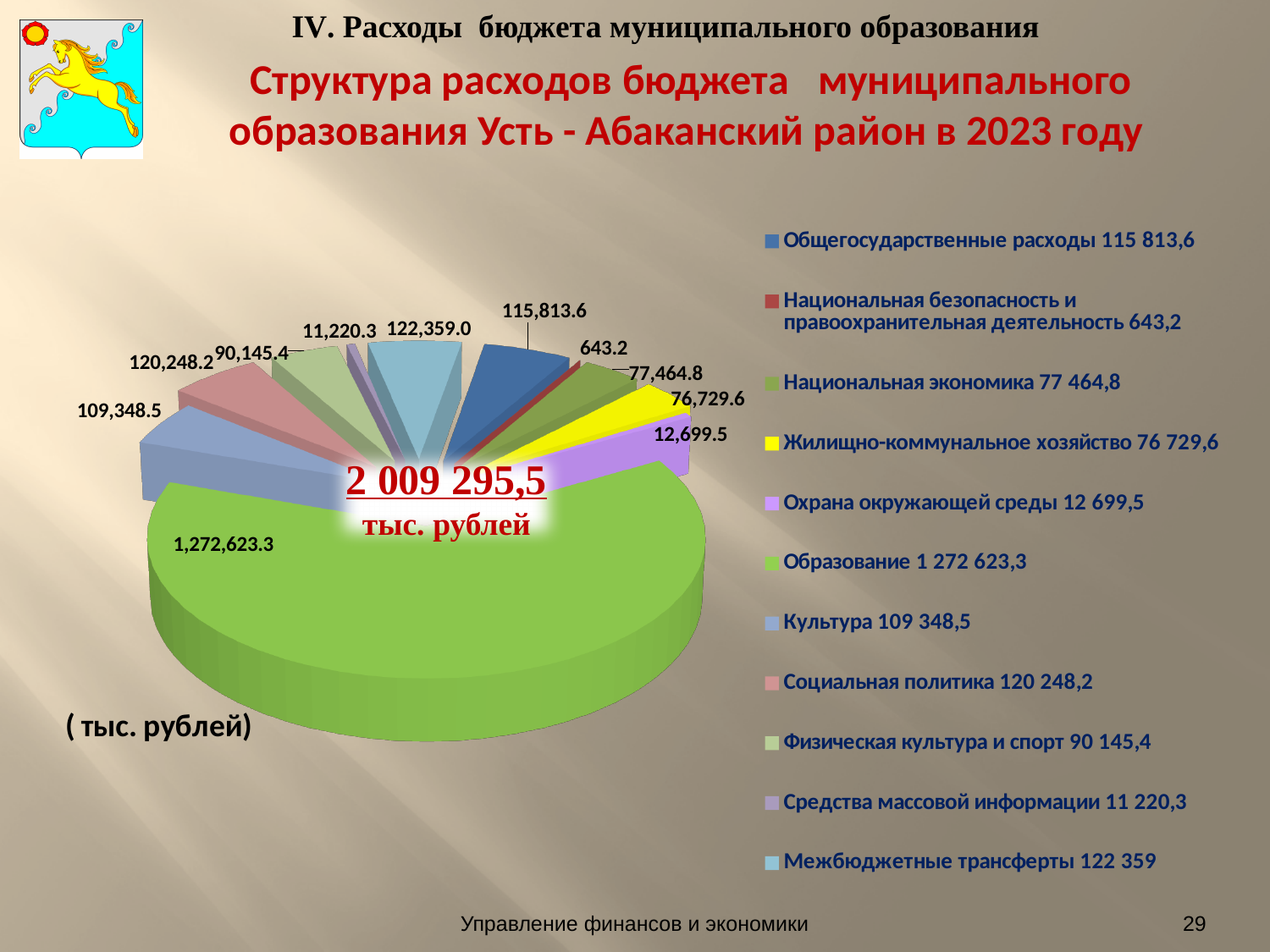
What is the value for Охрана окружающей среды? 12,699.5 What is the value for Образование in the pie chart? 1,272,623.3 What total amount is printed in the centre of the pie chart? 2 009 295,5 тыс. рублей What is the value for Национальная безопасность и правоохранительная деятельность? 643.2 Which category has the largest slice of the pie? Образование What is the value for Межбюджетные трансферты? 122,359.0 What is the difference between Межбюджетные трансферты (122,359.0) and Социальная политика (120,248.2)? 2,110.8 What type of chart is shown on the slide? pie chart What is the difference between Общегосударственные расходы (115,813.6) and Культура (109,348.5)? 6,465.1 Which category has the smallest slice of the pie? Национальная безопасность и правоохранительная деятельность How many categories does the legend list? 11 Which is larger: Национальная экономика or Жилищно-коммунальное хозяйство? Национальная экономика